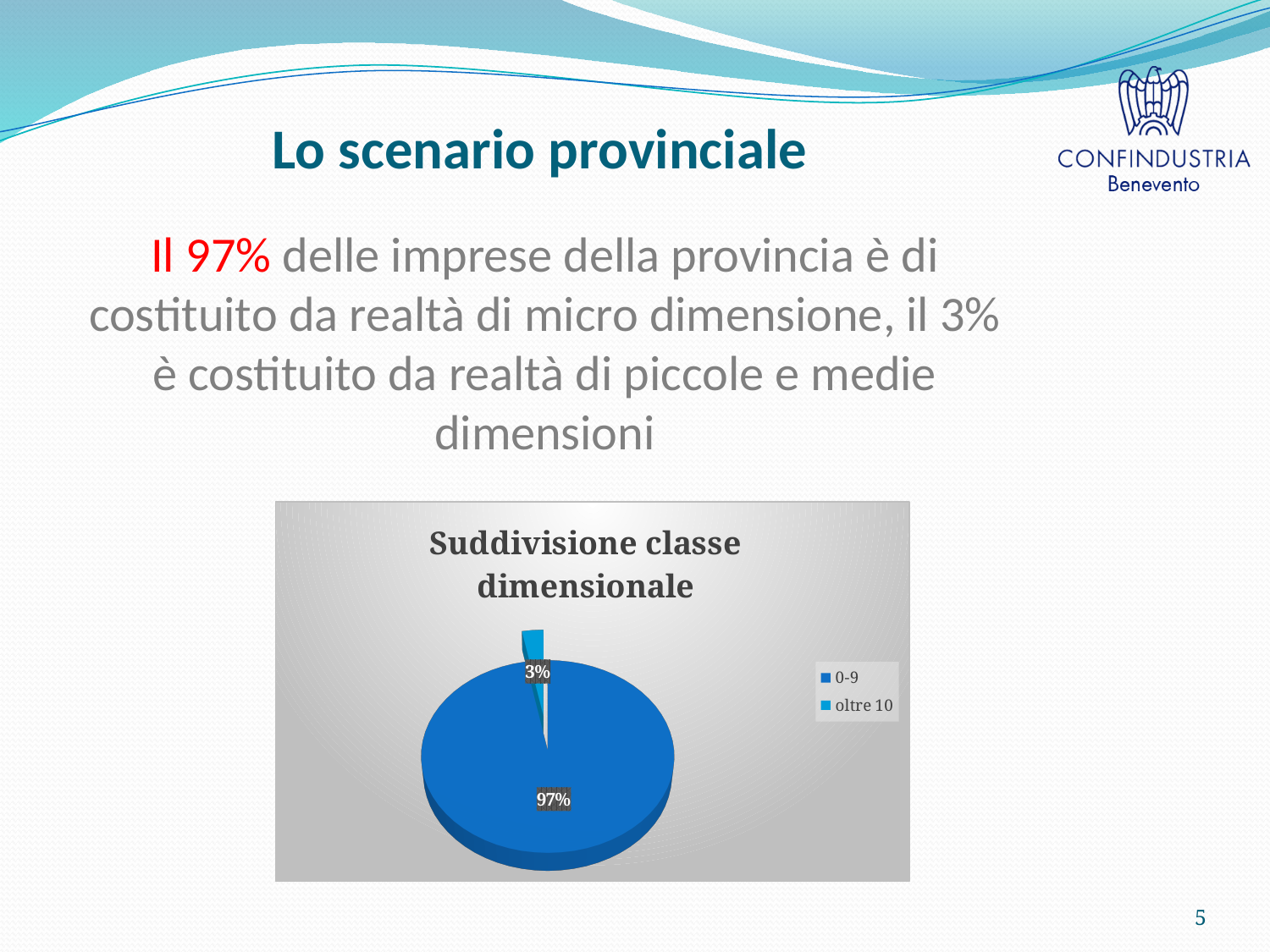
What share of the pie does the "oltre 10" slice represent? 3% What is the difference in percentage points between the "0-9" slice and the "oltre 10" slice? 94 percentage points What are the two legend entries of the chart? 0-9 and oltre 10 Which slice is larger, "0-9" or "oltre 10"? 0-9 Is the share for "0-9" greater or less than 50%? greater How many entries does the legend list? 2 What is the title of the chart? Suddivisione classe dimensionale What kind of chart is shown on the slide? pie chart How many categories does the pie chart show? 2 Which category has the smallest slice of the pie? oltre 10 What share of the pie does the "0-9" slice represent? 97% Which category has the largest slice of the pie? 0-9